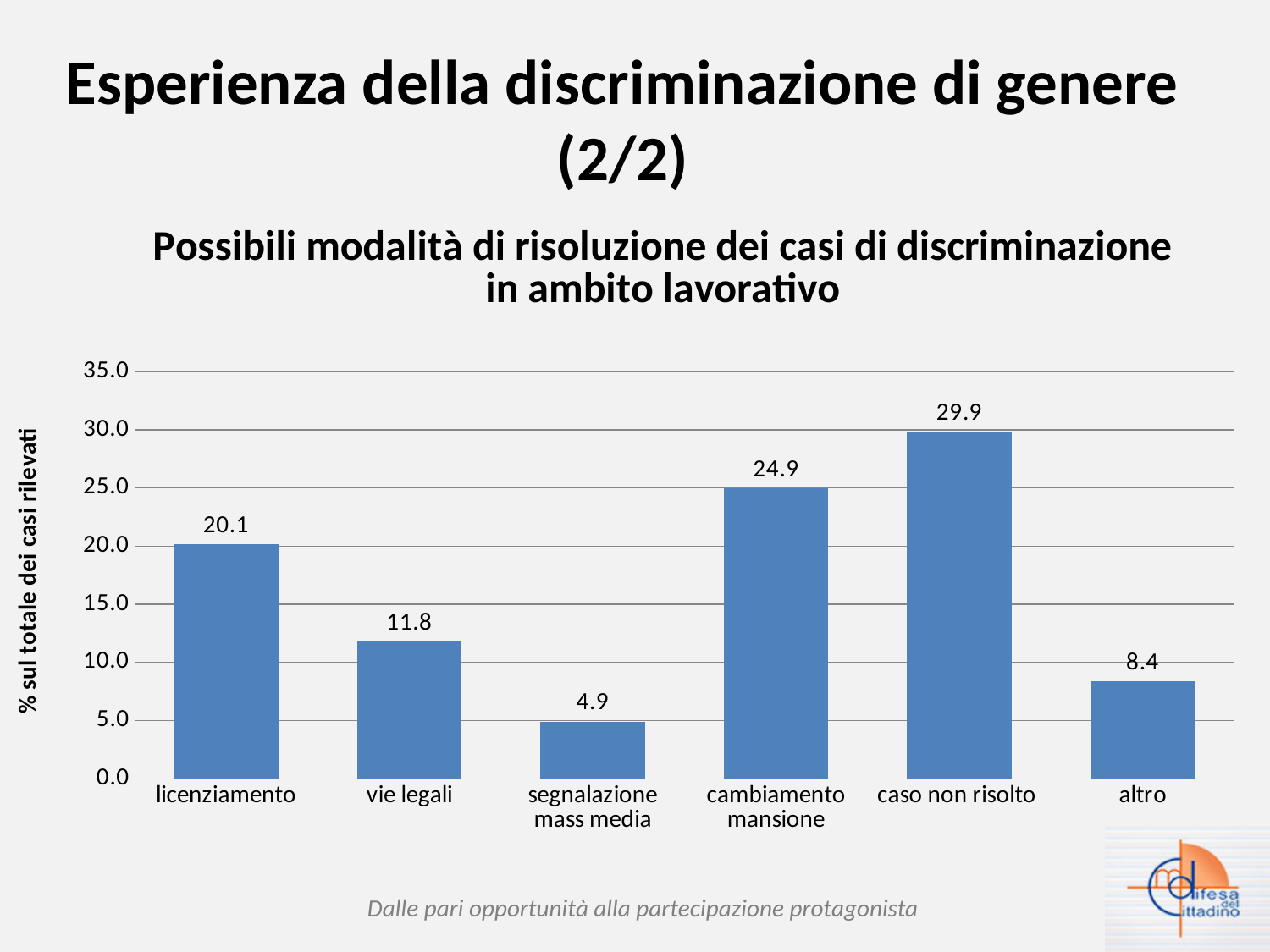
How many categories are shown on the x axis? 6 What is the label of the vertical axis? % sul totale dei casi rilevati What is the value for 'vie legali'? 11.8 Which category has the highest value? caso non risolto What is the value for 'segnalazione mass media'? 4.9 What is the value for 'caso non risolto'? 29.9 Which is larger, the value for 'licenziamento' or the value for 'vie legali'? licenziamento What is the difference between the values for 'caso non risolto' and 'cambiamento mansione'? 5.0 Which category has the lowest value? segnalazione mass media What kind of chart is shown on the slide? bar chart Is the value for 'cambiamento mansione' greater or less than 20.0? greater What is the difference between the values for 'licenziamento' and 'altro'? 11.7